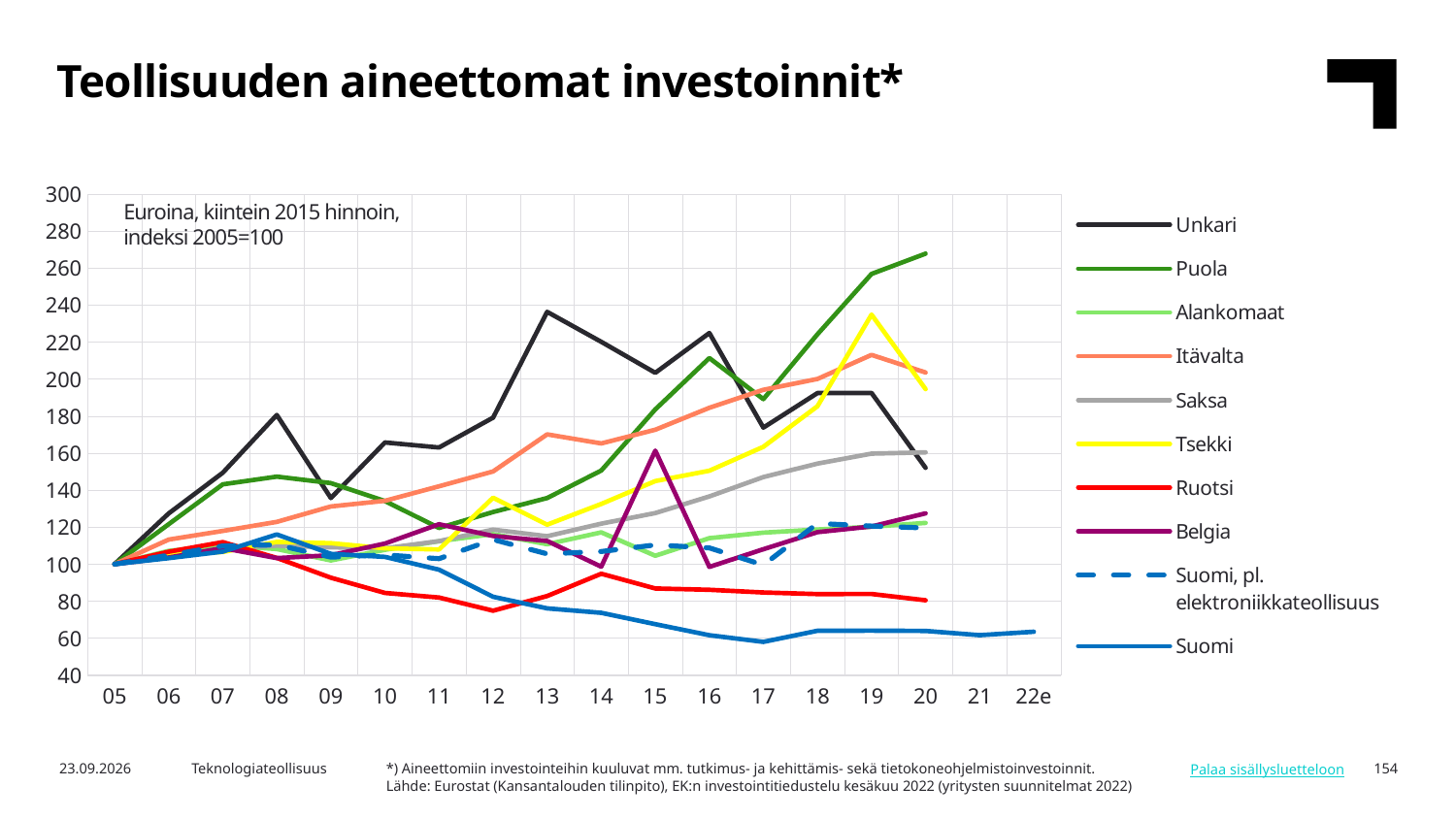
Is the value for Puola in 2020 greater or less than 260? greater Which series is drawn with a dashed line? Suomi, pl. elektroniikkateollisuus Does the Suomi series rise or fall overall from 2005 to 2020? fall What is the index value of the series in the base year 2005? 100 Is the value for Unkari in 2013 greater or less than 220? greater What kind of chart is shown on the slide? line chart Is the value for Ruotsi in 2012 greater or less than 80? less Which is higher in 2020, Itävalta or Saksa? Itävalta How many series does the legend list? 10 Which series has the lowest value in 2020? Suomi Which series has the highest value in 2020? Puola